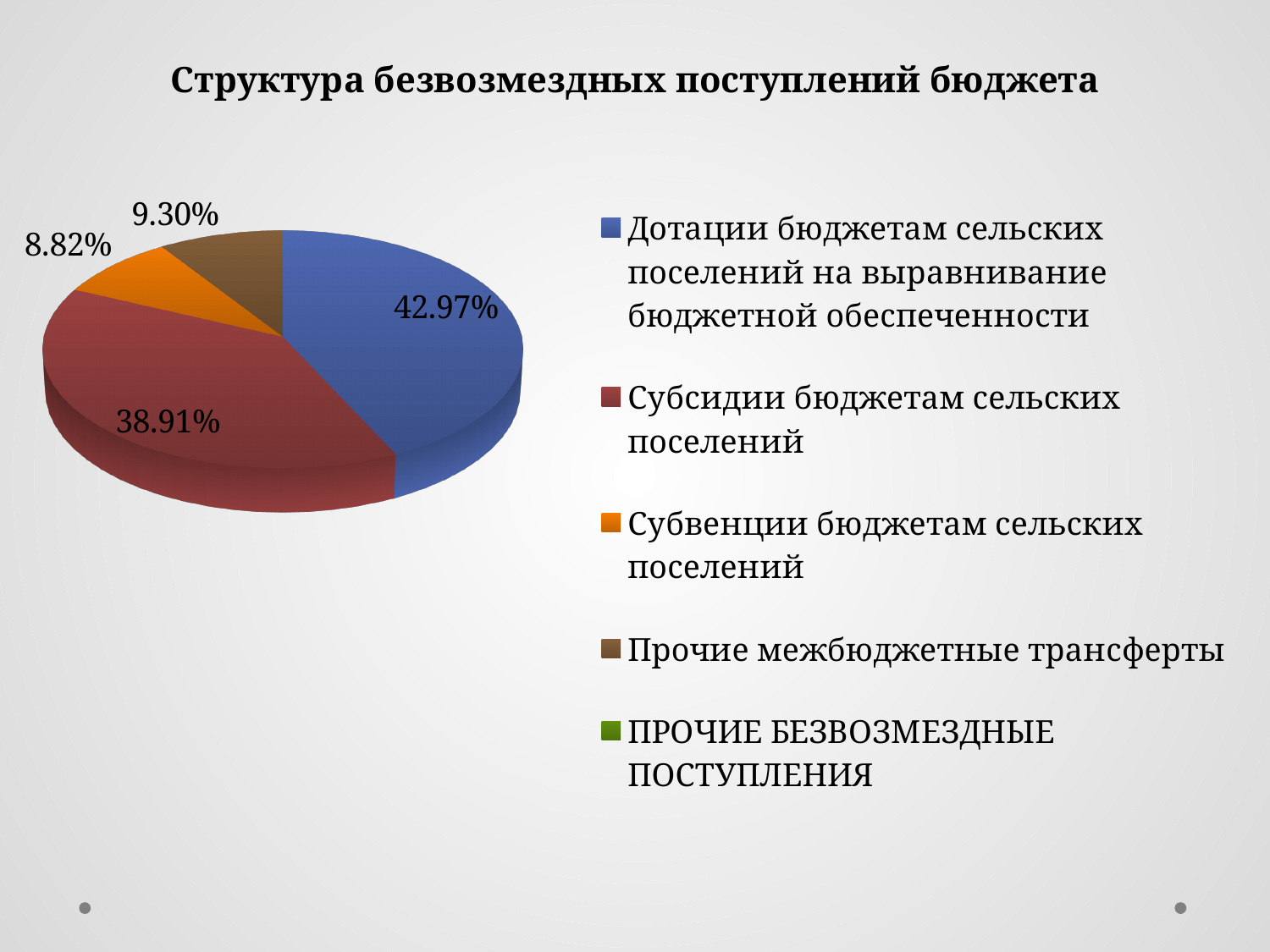
Among the slices with printed labels, which category has the smallest share? Субвенции бюджетам сельских поселений Which category has the largest slice of the pie? Дотации бюджетам сельских поселений на выравнивание бюджетной обеспеченности Which is larger: the share for 'Прочие межбюджетные трансферты' or the share for 'Субвенции бюджетам сельских поселений'? Прочие межбюджетные трансферты What share of the pie is 'Субвенции бюджетам сельских поселений'? 8.82% What share of the pie is 'Прочие межбюджетные трансферты'? 9.30% What share of the pie is 'Дотации бюджетам сельских поселений на выравнивание бюджетной обеспеченности'? 42.97% What colour is the slice for 'Субсидии бюджетам сельских поселений'? Red What type of chart is shown on the slide? Pie chart What share of the pie is 'Субсидии бюджетам сельских поселений'? 38.91% What is the difference in percentage points between the 'Дотации' slice and the 'Субсидии' slice? 4.06 What is the title of the chart? Структура безвозмездных поступлений бюджета How many entries does the legend list? 5